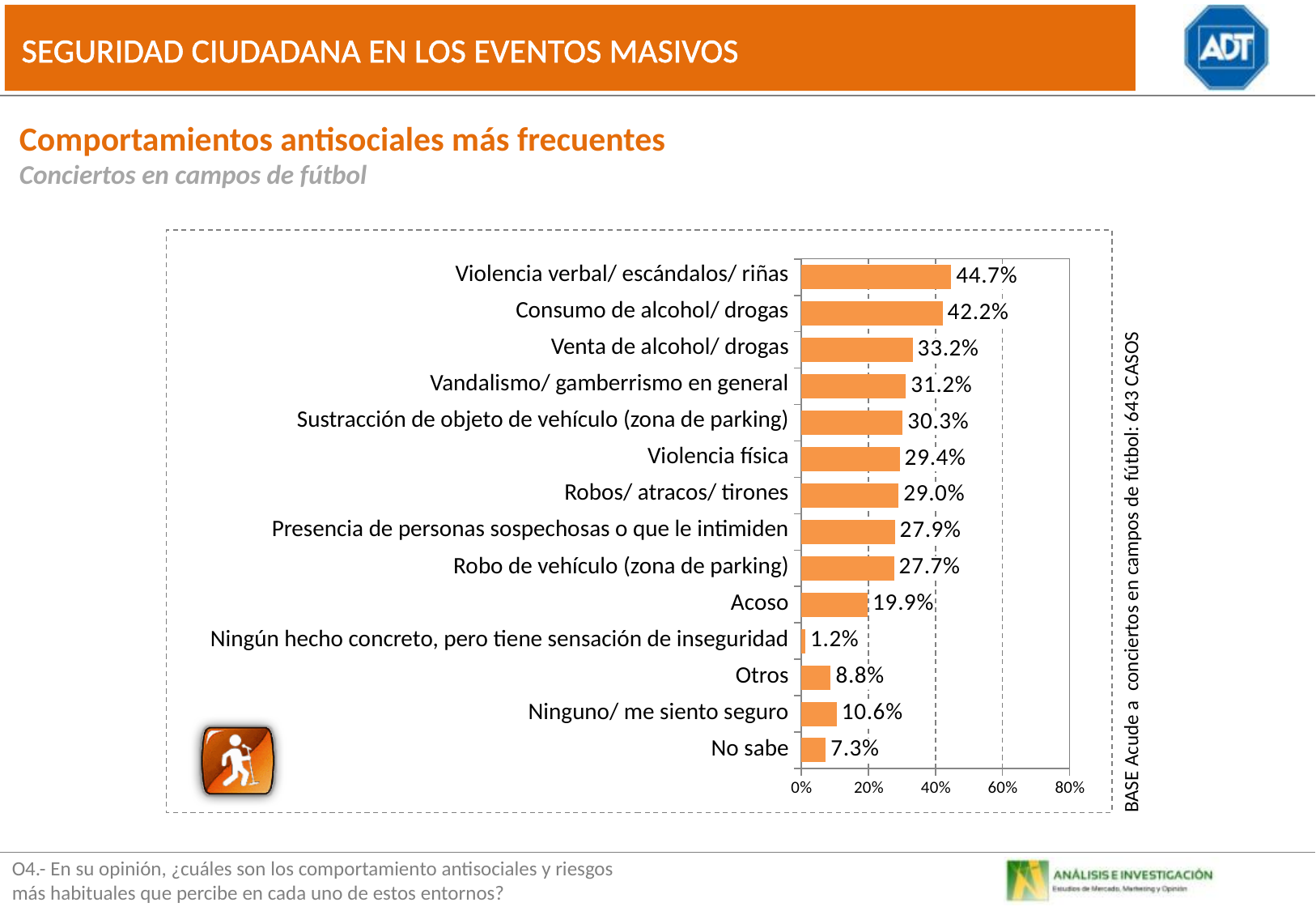
What is the base (number of cases) stated for the chart? 643 CASOS What is the value for Robo de vehículo (zona de parking)? 27.7% Which category has the highest value? Violencia verbal/ escándalos/ riñas What is the difference between Consumo de alcohol/ drogas and Venta de alcohol/ drogas? 9.0% Which category has the lowest value? Ningún hecho concreto, pero tiene sensación de inseguridad What is the value for Acoso? 19.9% Which is larger, Otros or No sabe? Otros Is the value for Vandalismo/ gamberrismo en general greater or less than 20%? greater What kind of chart is shown on the slide? Bar chart What is the value for Violencia verbal/ escándalos/ riñas? 44.7% What is the value for Ninguno/ me siento seguro? 10.6% How many categories are shown in the chart? 14